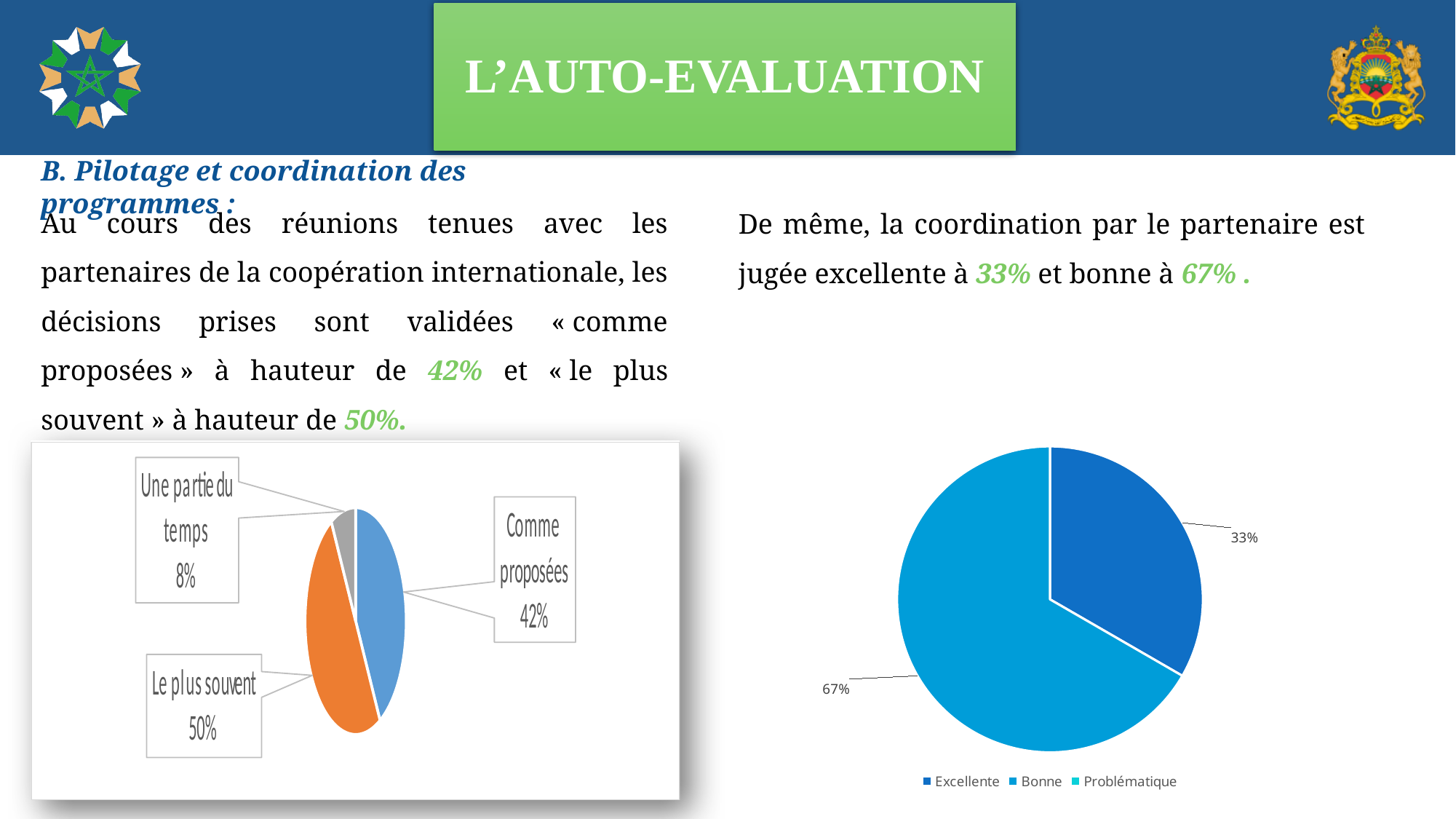
On the right pie chart, what share is labelled for the 'Excellente' slice? 33% On the right pie chart, which is larger, the 'Excellente' slice or the 'Bonne' slice? Bonne On the right pie chart, what share is labelled for the 'Bonne' slice? 67% On the left pie chart, what is the difference between the 'Le plus souvent' share and the 'Comme proposées' share? 8% On the left pie chart, which category has the largest slice? Le plus souvent On the left pie chart, which category has the smallest slice? Une partie du temps On the left pie chart, what share is labelled 'Une partie du temps'? 8% How many entries does the legend of the right pie chart list? 3 What type of chart is shown on the right side of the slide? Pie chart On the left pie chart, what share is labelled 'Le plus souvent'? 50% On the left pie chart, what share is labelled 'Comme proposées'? 42% On the left pie chart, how many slices are labelled? 3